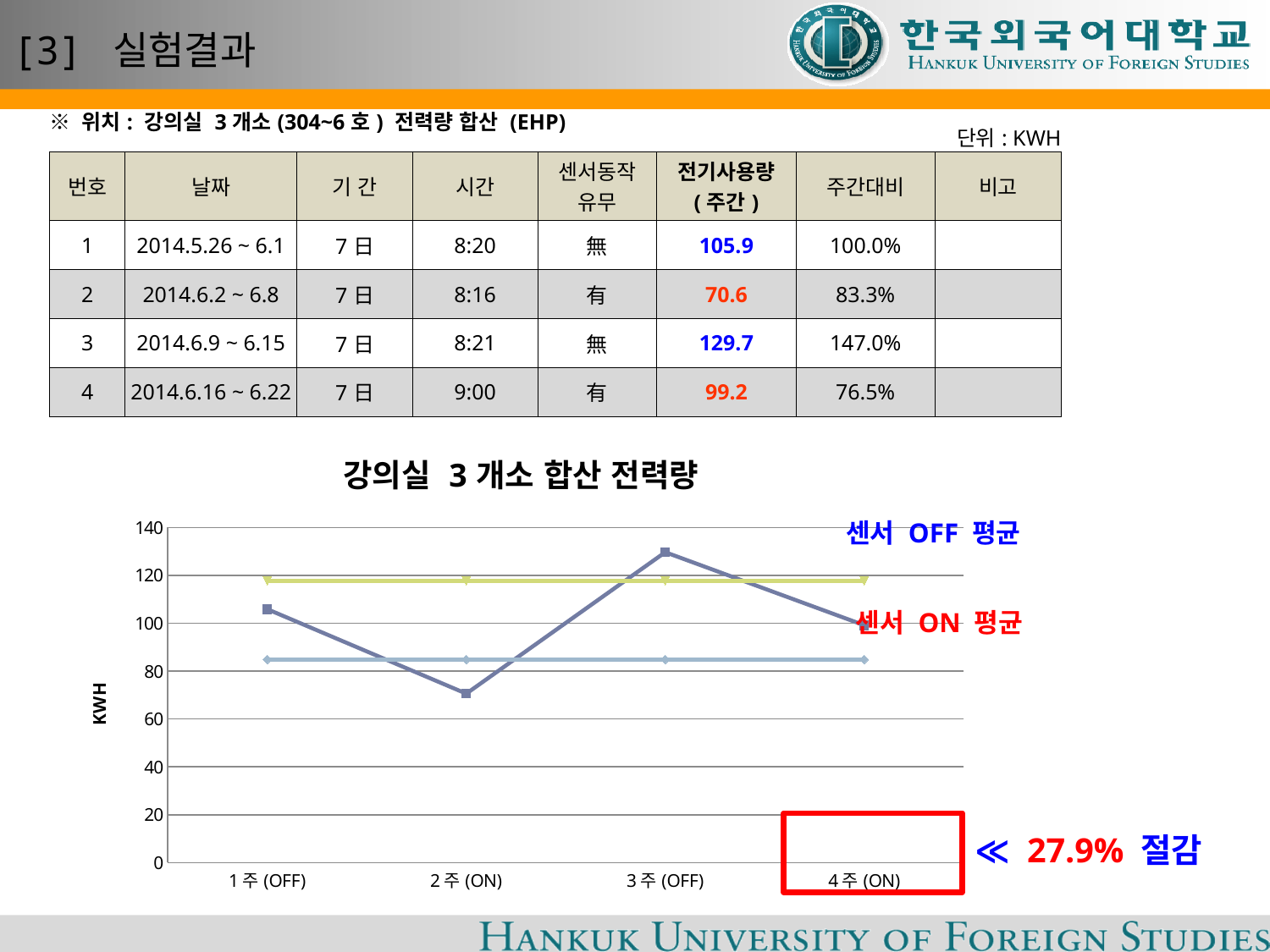
How many weekly data points are plotted along the x axis of the chart? 4 What is the title of the chart? 강의실 3개소 합산 전력량 Which week has the lowest value on the chart? 2주 (ON) Is the value for 2주 (ON) greater or less than 80? less Does the plotted line rise or fall from 2주 (ON) to 3주 (OFF)? rise What unit is shown on the y axis of the chart? KWH Which is larger, the value for 1주 (OFF) or the value for 2주 (ON)? 1주 (OFF) What kind of chart is shown on the slide? line chart Which week has the highest value on the chart? 3주 (OFF) Is the value for 3주 (OFF) greater or less than 120? greater Is the value for 4주 (ON) greater or less than 80? greater